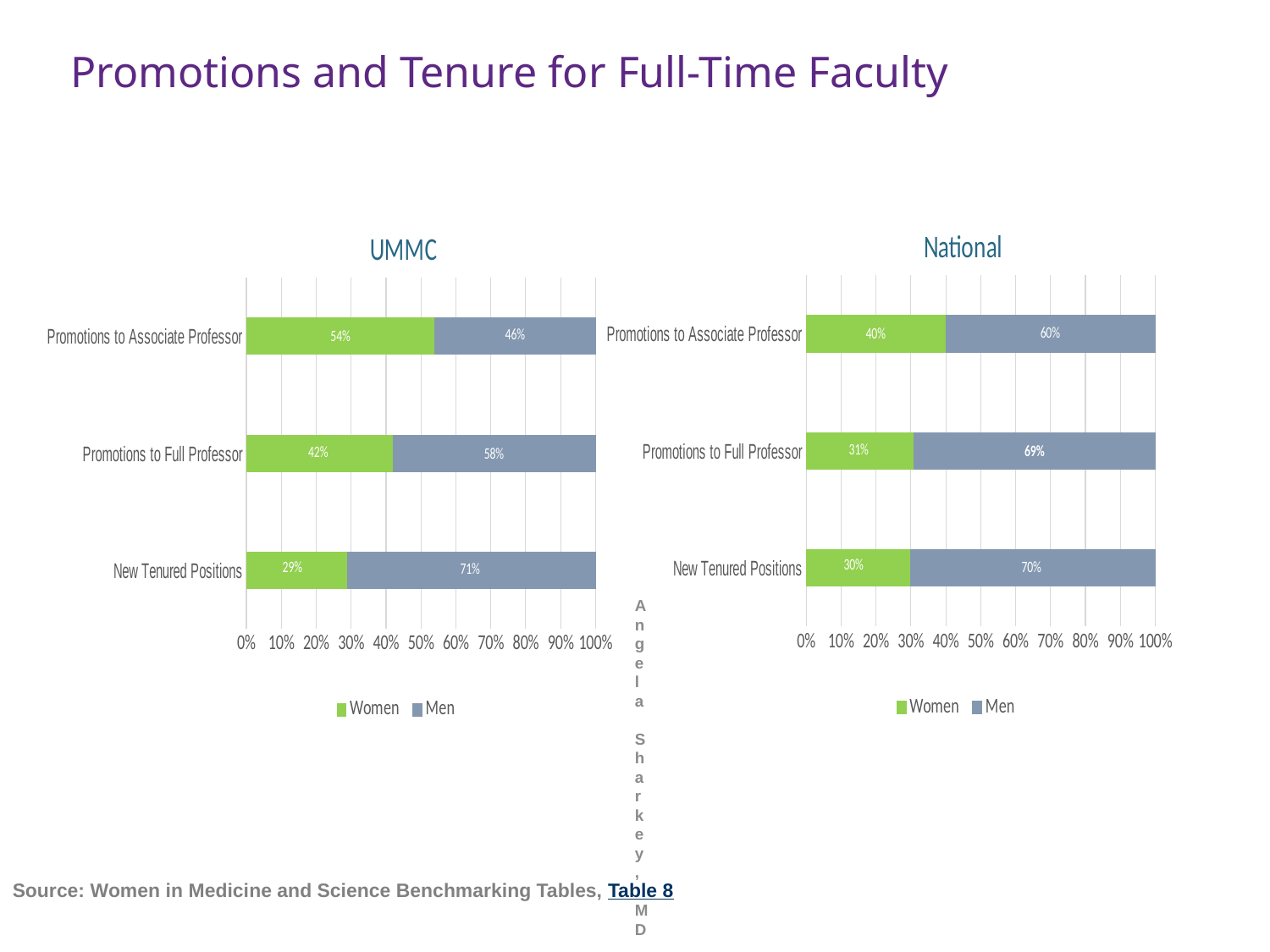
In the National chart, which category has the lowest Women share? New Tenured Positions In the National chart, what percentage of Promotions to Full Professor went to Men? 69% How many series does the legend of the UMMC chart list? 2 Is the Women value for Promotions to Associate Professor larger in the UMMC chart or the National chart? UMMC In the National chart, what is the Women value for New Tenured Positions? 30% In the UMMC chart, what is the total of the stacked bar for New Tenured Positions? 100% In the UMMC chart, what is the difference between the Men and Women values for Promotions to Full Professor? 16% In the UMMC chart, which category has the highest Women share? Promotions to Associate Professor In the UMMC chart, what percentage of Promotions to Associate Professor went to Women? 54% In the UMMC chart, what is the Men value for New Tenured Positions? 71% How many categories are shown in the National chart? 3 What type of chart is the UMMC chart? Stacked bar chart